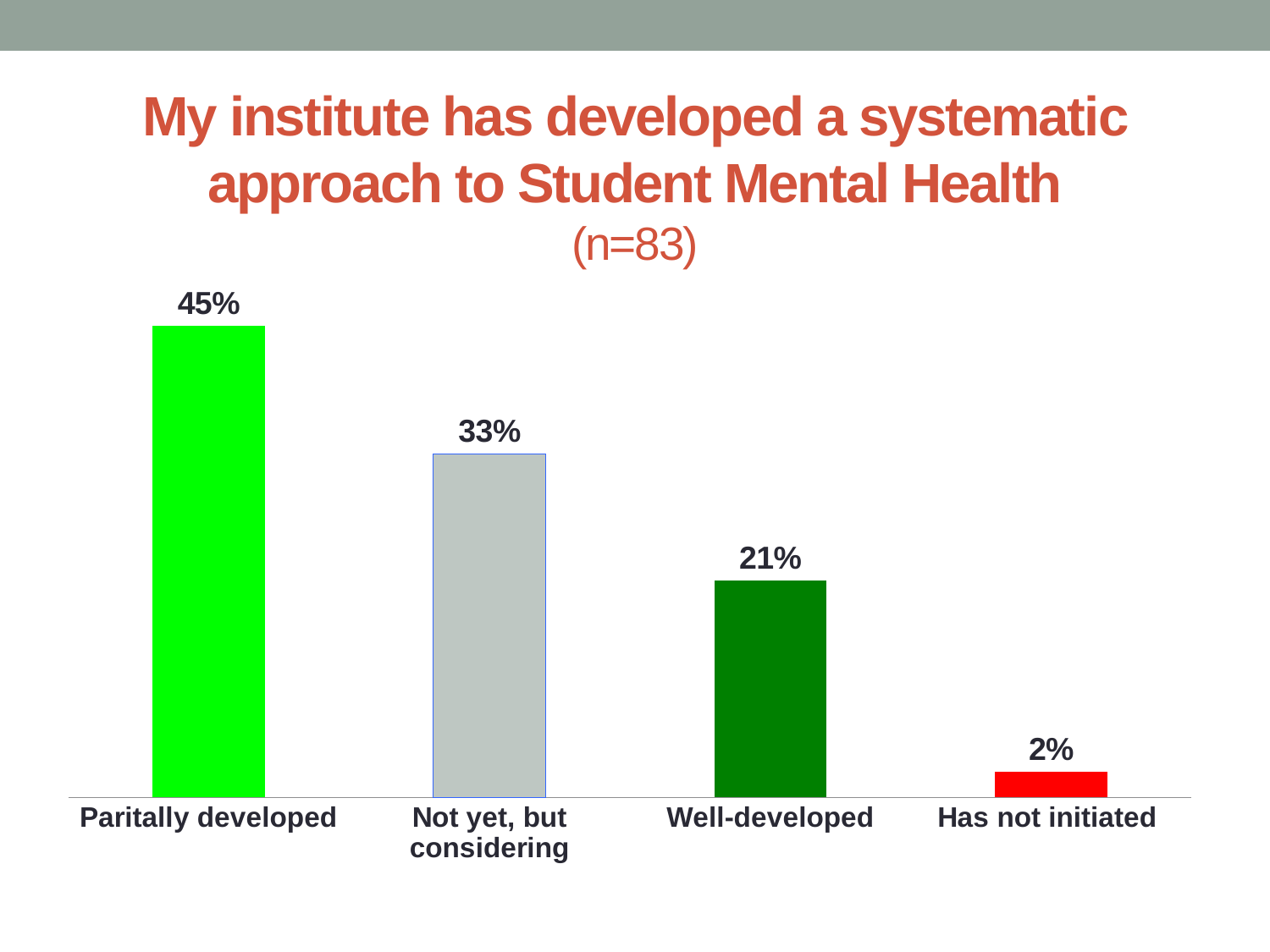
How many categories are shown in the chart? 4 Which category has the highest percentage? Paritally developed What percentage is shown for "Well-developed"? 21% What percentage is shown for "Paritally developed"? 45% What kind of chart is shown on the slide? Bar chart Which category has the lowest percentage? Has not initiated What is the difference in percentage points between "Not yet, but considering" and "Has not initiated"? 31 Which is larger: the value for "Not yet, but considering" or the value for "Well-developed"? Not yet, but considering What is the difference in percentage points between "Paritally developed" and "Well-developed"? 24 What sample size (n) is stated in the chart title? n=83 What percentage is shown for "Has not initiated"? 2% What percentage is shown for "Not yet, but considering"? 33%